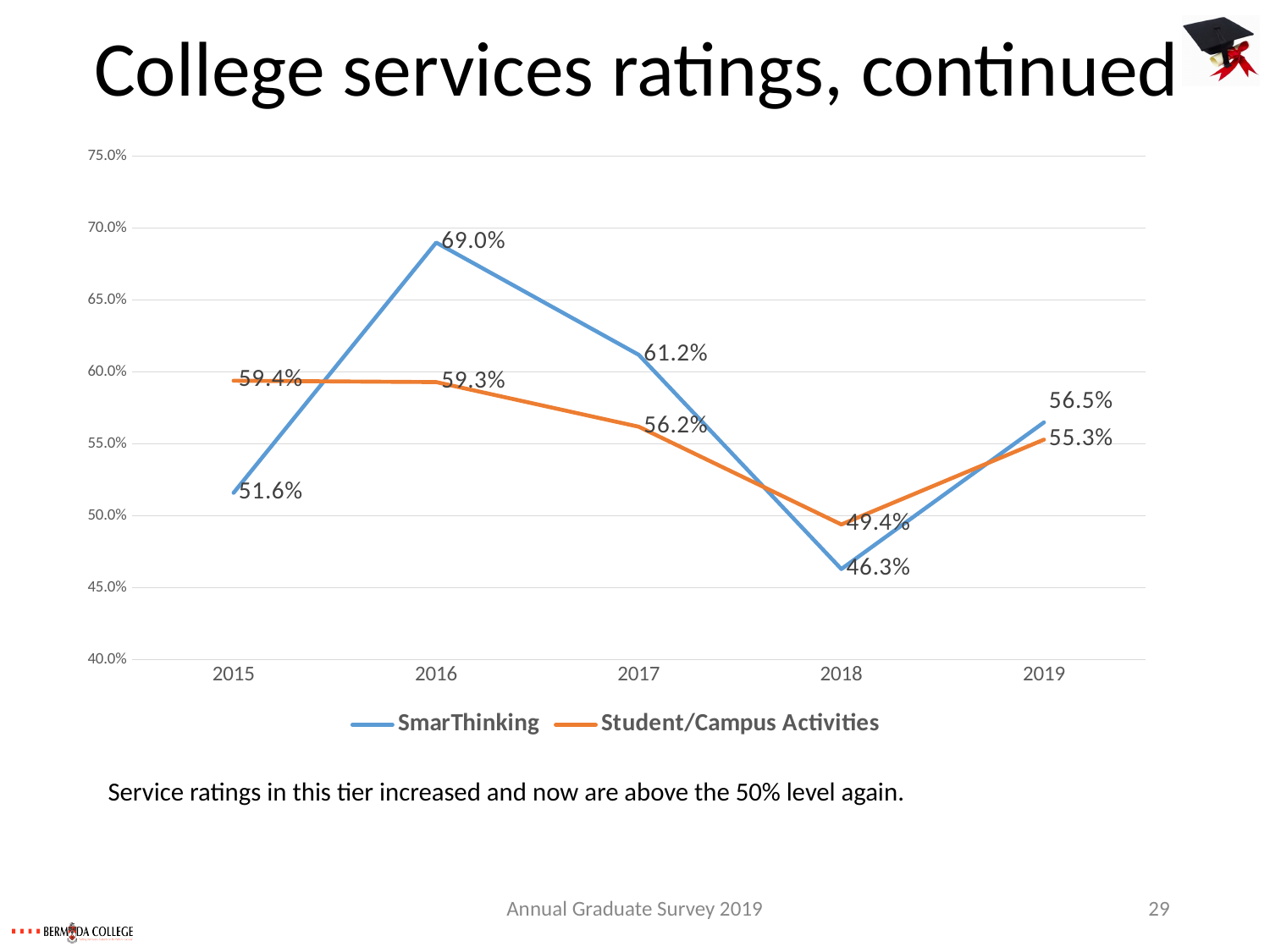
What is the SmarThinking rating for 2019? 56.5% How many years are shown on the x axis? 5 What is the difference between the SmarThinking and Student/Campus Activities ratings in 2017? 5.0% What is the SmarThinking rating for 2016? 69.0% In which year is the Student/Campus Activities rating lowest? 2018 Is the SmarThinking rating for 2018 greater or less than 50.0%? less In which year is the SmarThinking rating highest? 2016 What is the Student/Campus Activities rating for 2018? 49.4% Does the Student/Campus Activities rating rise or fall from 2015 to 2018? fall How many series does the legend list? 2 What kind of chart is shown on the slide? line chart Which series has the higher rating in 2015, SmarThinking or Student/Campus Activities? Student/Campus Activities